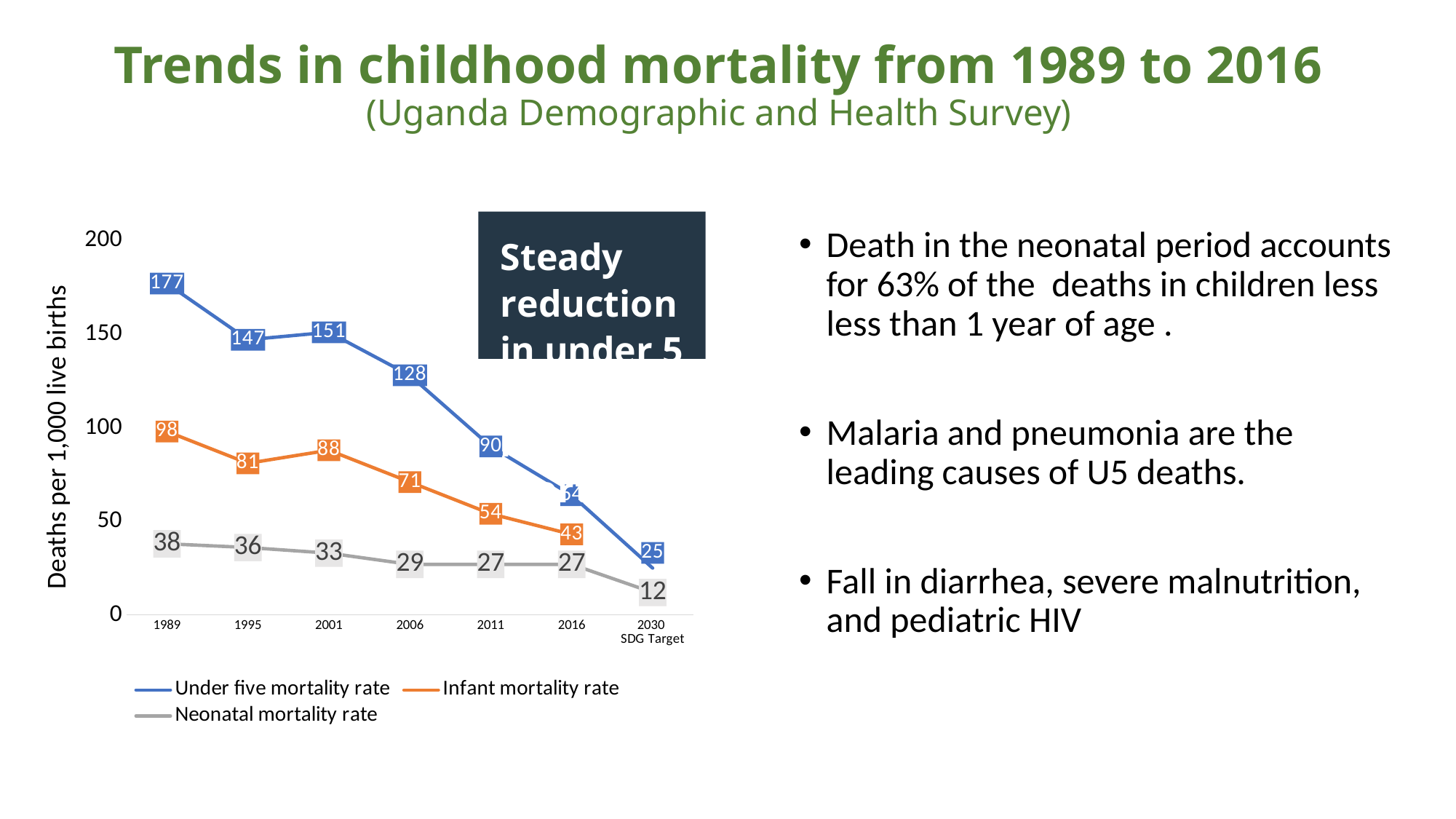
How many series does the chart legend list? 3 What is the neonatal mortality rate value for the 2030 SDG Target? 12 What is the difference between the under five mortality rate in 1989 and in 2006? 49 How many x-axis categories (time points) are shown on the chart? 7 Which is larger: the under five mortality rate in 2011 or the infant mortality rate in 1989? Infant mortality rate in 1989 What is the difference between the infant mortality rate in 1989 and the neonatal mortality rate in 1989? 60 What was the under five mortality rate in 1989? 177 In which year was the under five mortality rate highest? 1989 What type of chart is shown on the slide? Line chart Does the neonatal mortality rate rise or fall from 1989 to the 2030 SDG Target? Fall What was the infant mortality rate in 2001? 88 Which year shows the lowest infant mortality rate? 2016